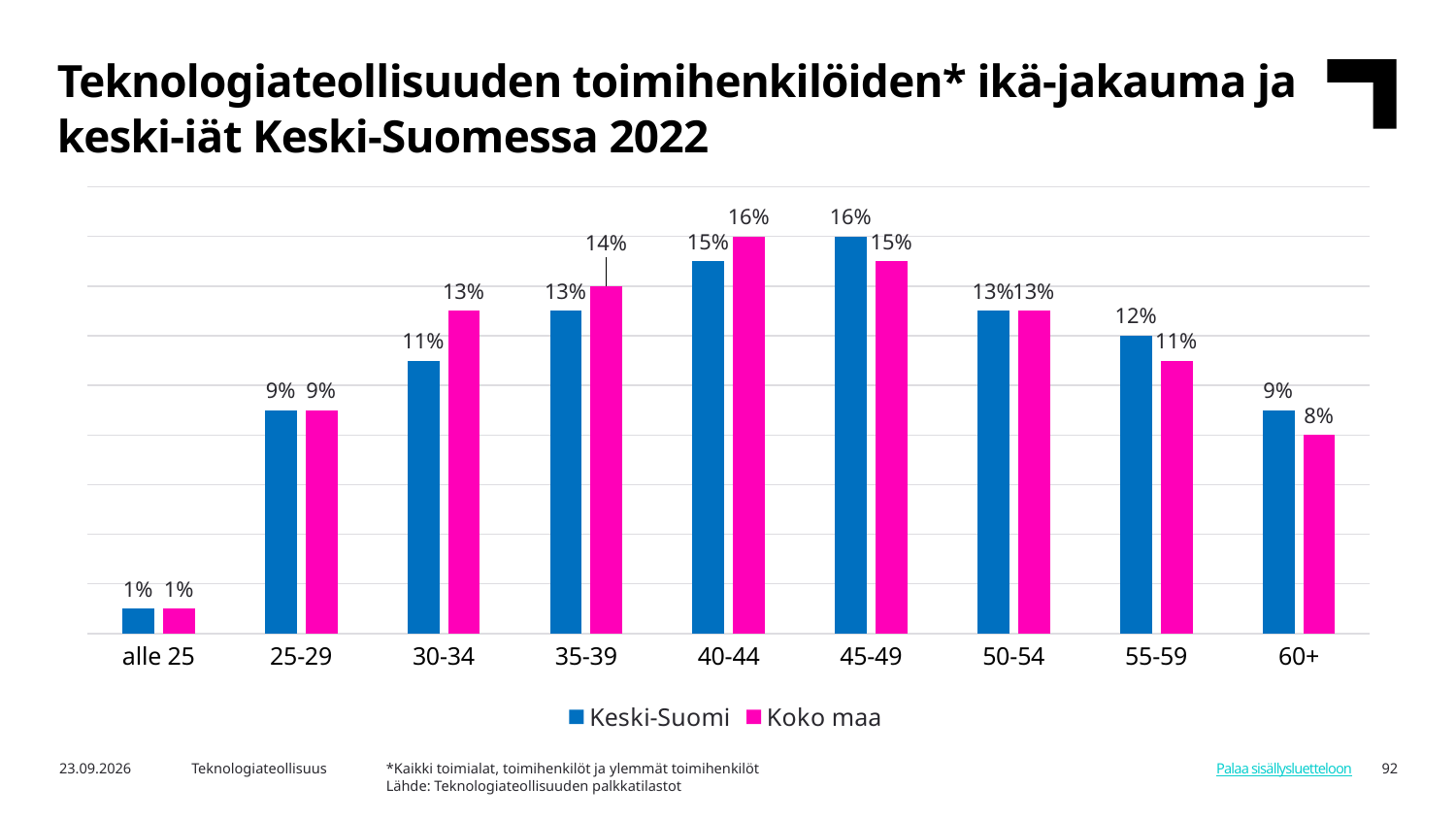
What is the value for Koko maa in the 60+ age group? 8% How many series does the legend list? 2 What is the difference between Koko maa and Keski-Suomi in the 30-34 age group? 2% What is the value for Keski-Suomi in the 45-49 age group? 16% In the 55-59 age group, which series has the larger value, Keski-Suomi or Koko maa? Keski-Suomi Which age group has the highest value for Keski-Suomi? 45-49 What kind of chart is shown on the slide? bar chart What is the value for Koko maa in the 30-34 age group? 13% Which series is shown in magenta in the legend? Koko maa Which age group has the highest value for Koko maa? 40-44 Which age group has the lowest value for Keski-Suomi? alle 25 How many age categories are shown on the x axis? 9